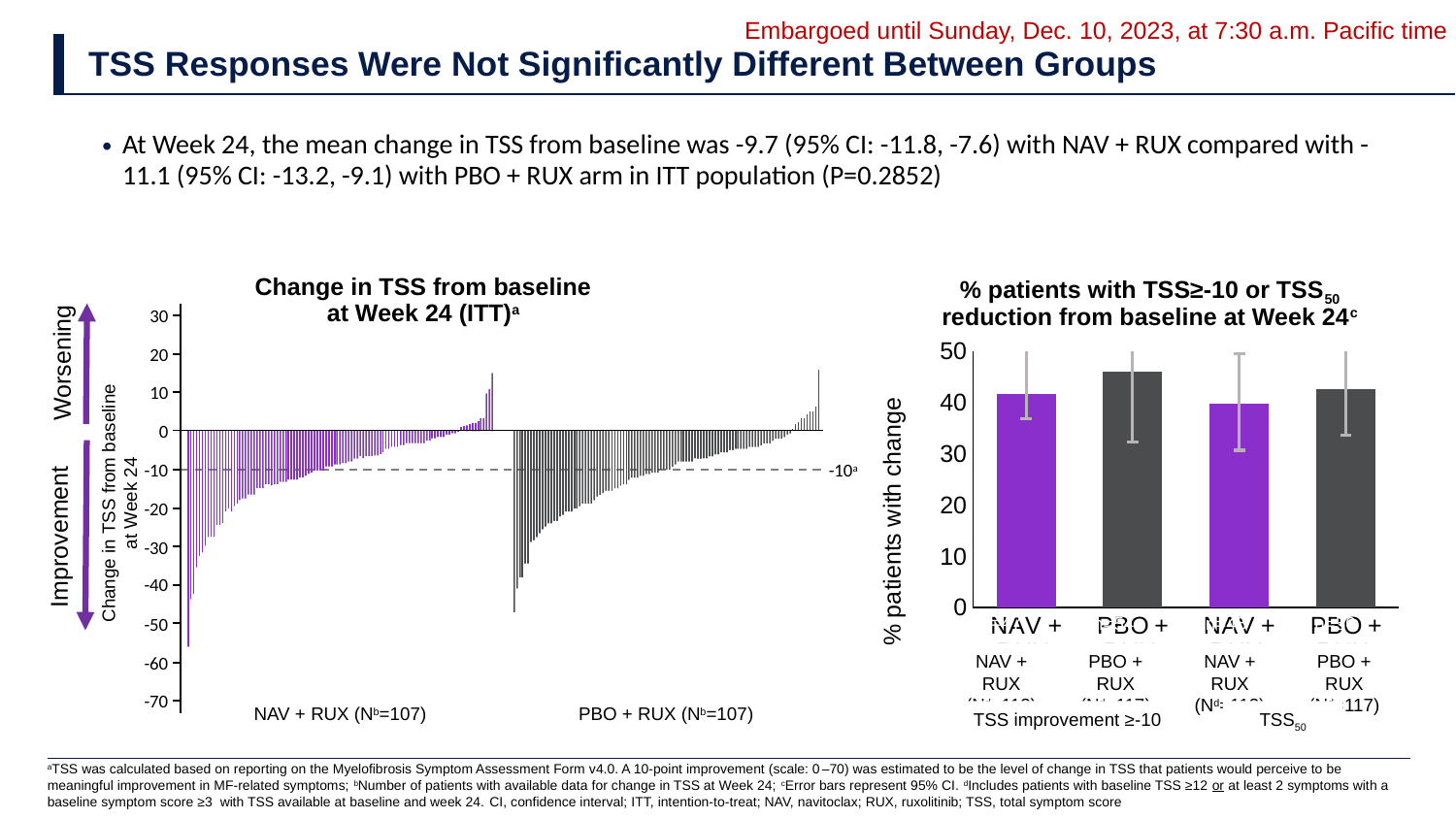
In the left chart 'Change in TSS from baseline at Week 24 (ITT)', at what value is the horizontal dashed reference line drawn? -10 In the right chart '% patients with TSS≥-10 or TSS50 reduction from baseline at Week 24', which bar is the highest? PBO + RUX, TSS improvement ≥-10 In the left chart 'Change in TSS from baseline at Week 24 (ITT)', how many treatment groups are shown? 2 In the left chart 'Change in TSS from baseline at Week 24 (ITT)', how many patients (N) are in the PBO + RUX group? 107 In the left chart 'Change in TSS from baseline at Week 24 (ITT)', is the largest decrease in the PBO + RUX group greater or less than -40? less In the left chart 'Change in TSS from baseline at Week 24 (ITT)', how many patients (N) are in the NAV + RUX group? 107 What kind of chart is the '% patients with TSS≥-10 or TSS50 reduction from baseline at Week 24' chart on the right? bar chart In the right chart '% patients with TSS≥-10 or TSS50 reduction from baseline at Week 24', for TSS improvement ≥-10, which group has the larger value, NAV + RUX or PBO + RUX? PBO + RUX In the right chart '% patients with TSS≥-10 or TSS50 reduction from baseline at Week 24', how many bars are plotted? 4 In the right chart '% patients with TSS≥-10 or TSS50 reduction from baseline at Week 24', is the value for PBO + RUX with TSS improvement ≥-10 greater or less than 50? less In the left chart 'Change in TSS from baseline at Week 24 (ITT)', is the largest decrease in the NAV + RUX group greater or less than -50? less What kind of chart is the 'Change in TSS from baseline at Week 24 (ITT)' chart on the left? bar chart